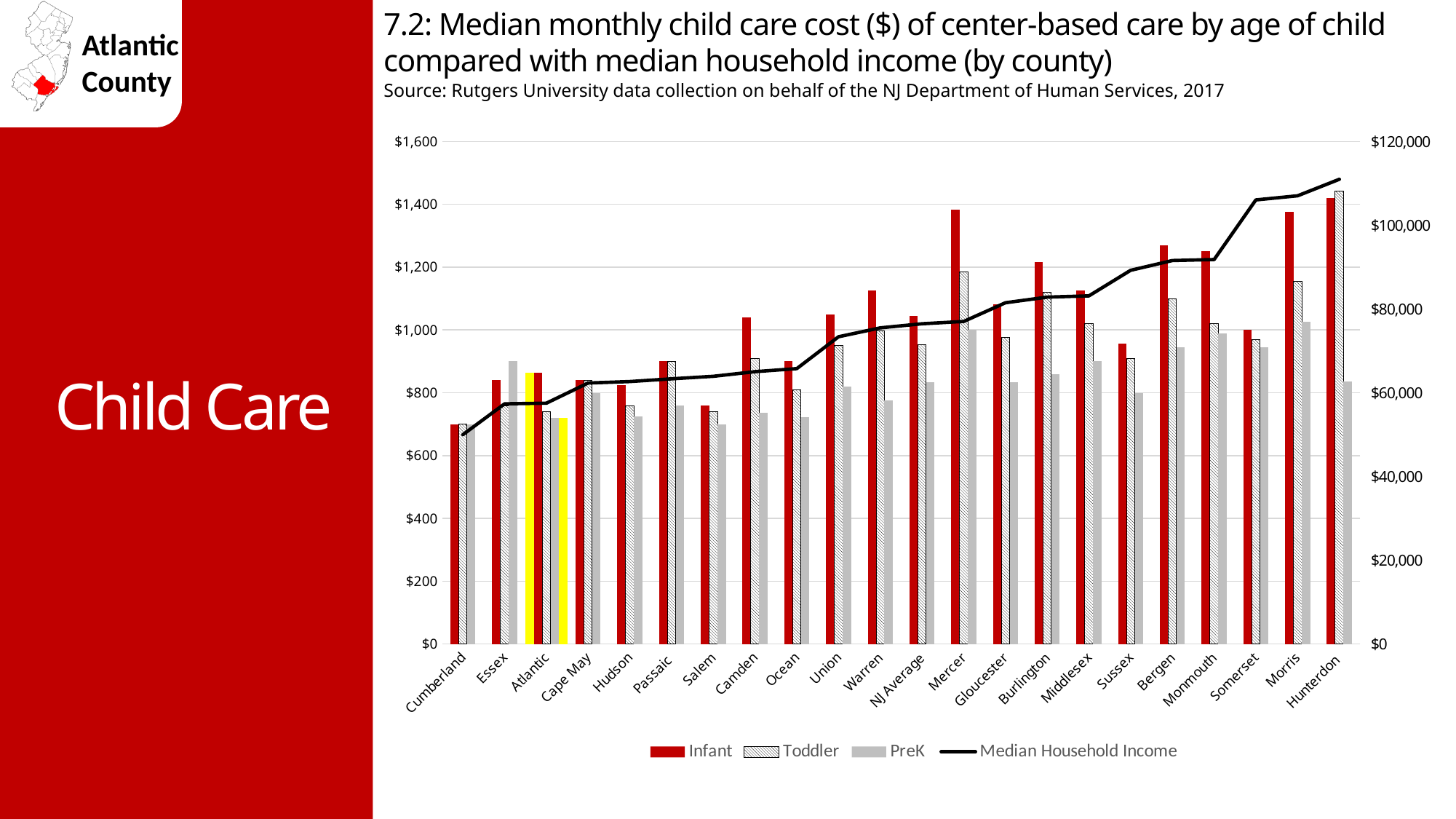
Which county has the highest Toddler cost? Hunterdon Which county has the highest Median Household Income? Hunterdon Is the Infant cost for Atlantic greater or less than $1,000? less How many counties (including NJ Average) are shown along the x axis? 22 Is the Infant cost for Mercer greater or less than $1,200? greater Does the Median Household Income line generally rise or fall from left to right across the counties? rise Which county has the lowest Infant cost? Cumberland How many series does the legend list? 4 Which is larger, the Infant cost for Mercer or the Infant cost for Gloucester? Mercer Is the Median Household Income for Hunterdon greater or less than $100,000? greater What kind of chart is shown on the slide? Bar chart with a line series Which county has the lowest Median Household Income? Cumberland